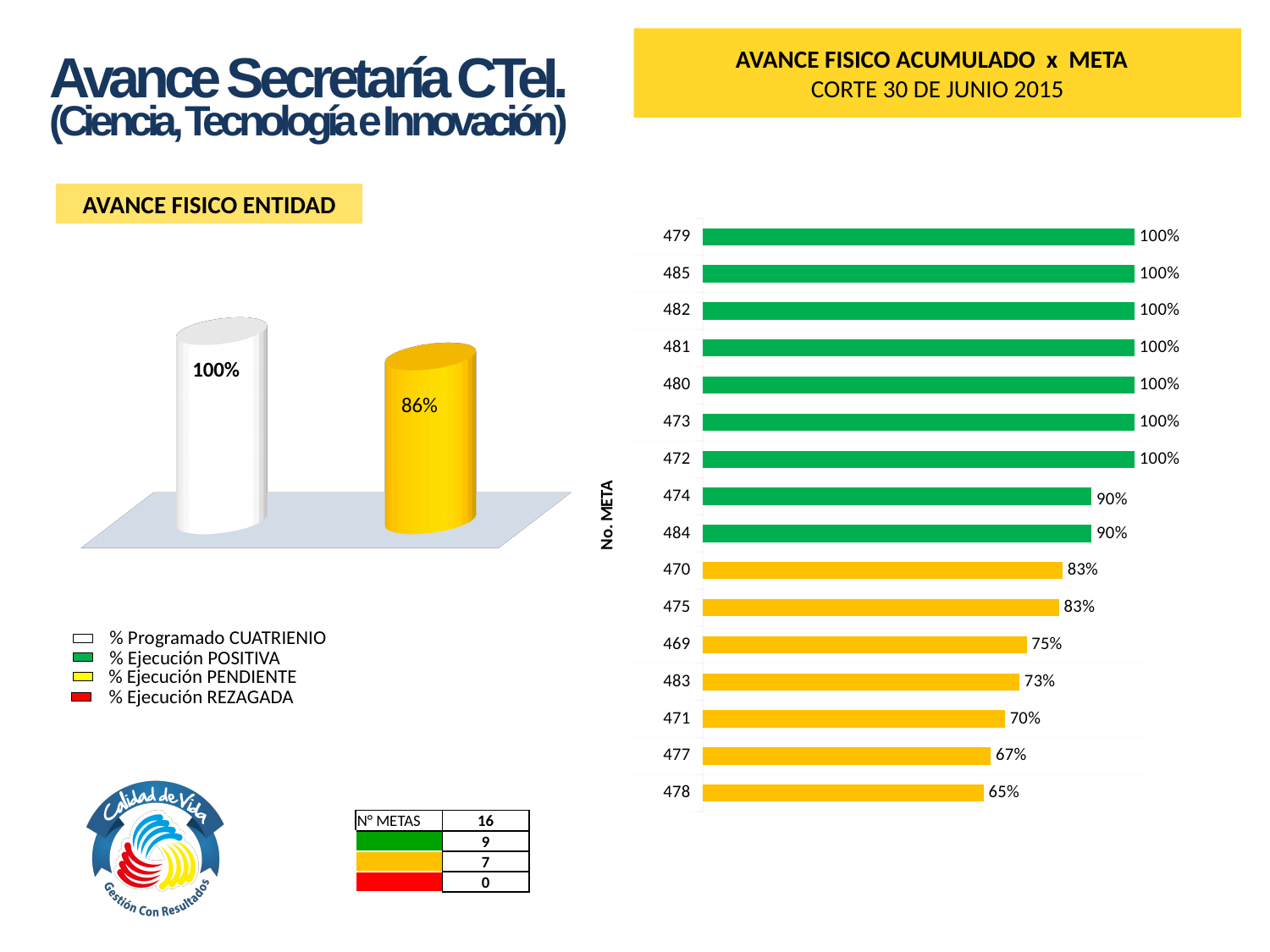
What is the axis title on the vertical axis of the AVANCE FISICO ACUMULADO x META chart? No. META In the AVANCE FISICO ACUMULADO x META chart, which is larger, the value for meta 470 or the value for meta 471? 470 How many metas are shown in the AVANCE FISICO ACUMULADO x META chart? 16 In the AVANCE FISICO ENTIDAD chart, what is the value of the yellow bar? 86% In the AVANCE FISICO ACUMULADO x META chart, which meta has the lowest value? 478 In the AVANCE FISICO ACUMULADO x META chart, what is the difference between the values for meta 469 and meta 477? 8% In the AVANCE FISICO ACUMULADO x META chart, what is the value for meta 474? 90% In the AVANCE FISICO ACUMULADO x META chart, what is the value for meta 478? 65% In the AVANCE FISICO ENTIDAD chart, what is the difference between the white bar and the yellow bar? 14% In the AVANCE FISICO ACUMULADO x META chart, what is the value for meta 483? 73% What kind of chart is the AVANCE FISICO ACUMULADO x META chart? Bar chart In the AVANCE FISICO ACUMULADO x META chart, how many metas have a value of 100%? 7